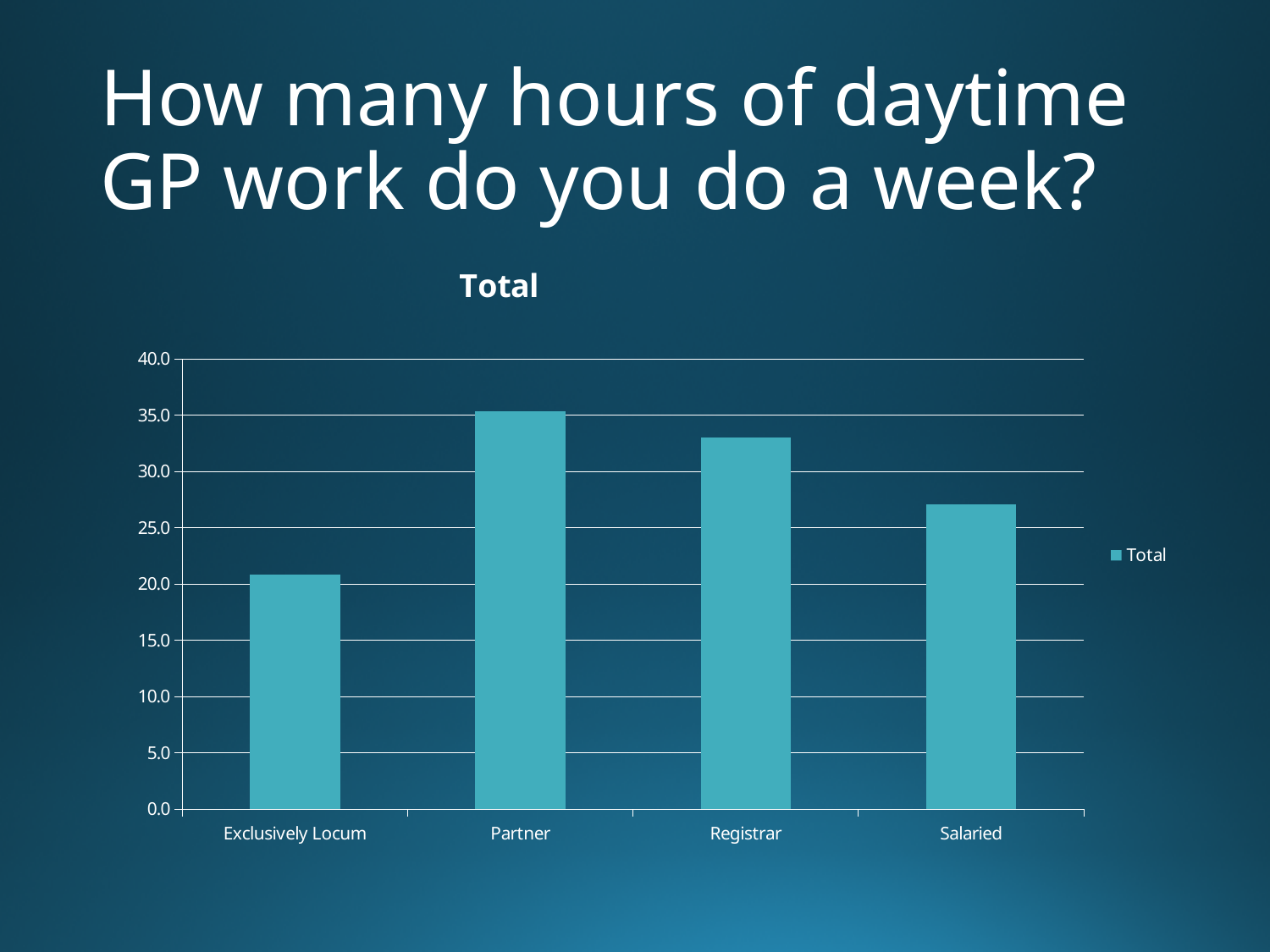
Is the value for Salaried greater or less than 25.0? greater How many series does the legend list? 1 How many categories are shown on the x axis? 4 Which is larger, the value for Registrar or the value for Salaried? Registrar Is the value for Registrar greater or less than 35.0? less Is the value for Salaried greater or less than 30.0? less What kind of chart is shown on the slide? bar chart Which is larger, the value for Partner or the value for Registrar? Partner Which category has the lowest value? Exclusively Locum Which category has the highest value? Partner